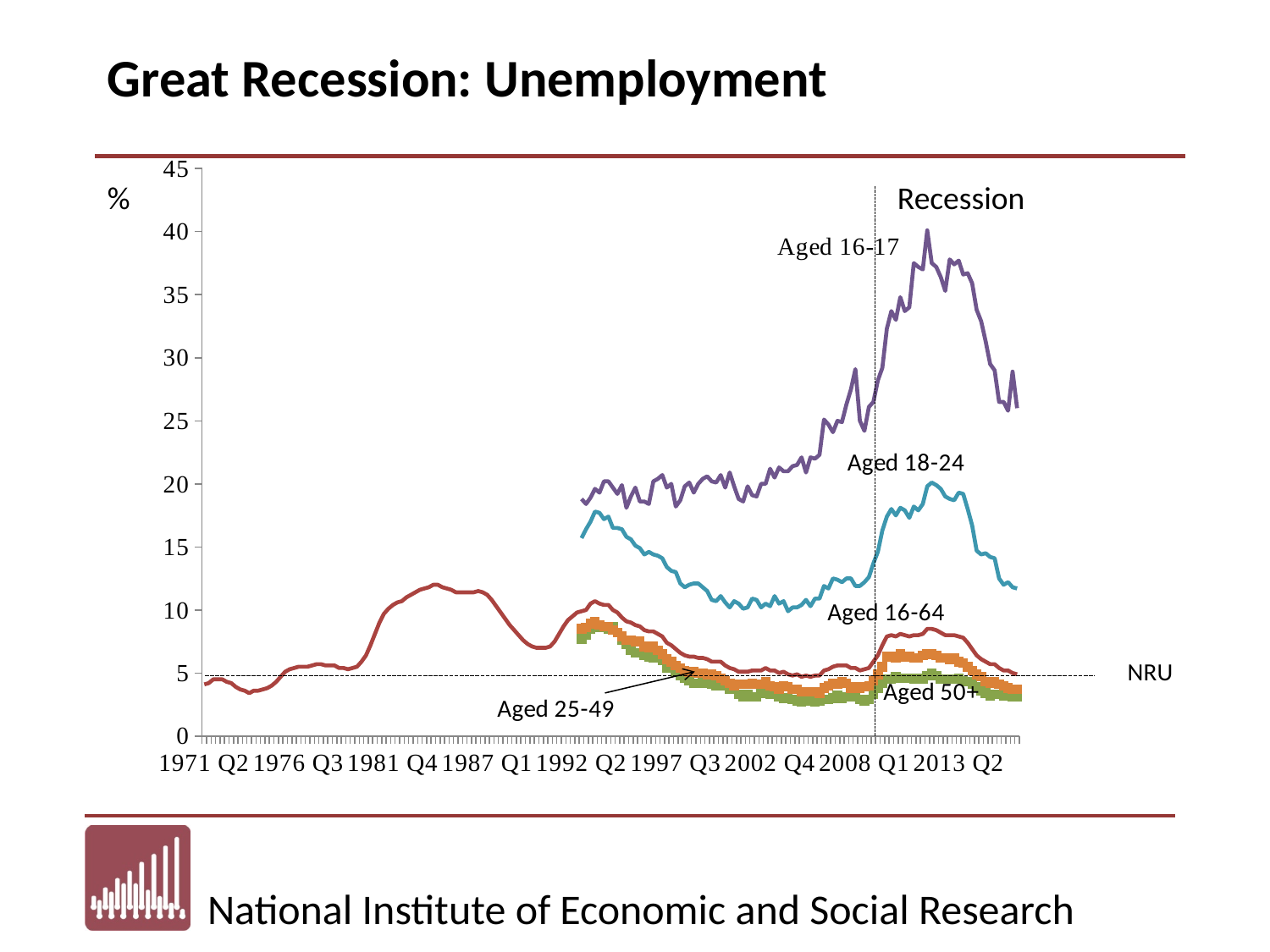
Is the peak value for Aged 18-24 greater or less than 15? greater Which age group has the highest unemployment rate throughout the period shown? Aged 16-17 What is the unit shown on the vertical axis? % Is the value for Aged 50+ at the end of the series greater or less than 5? less Is the peak value for Aged 18-24 greater or less than 25? less What is the title of the slide's chart? Great Recession: Unemployment What is the highest value shown on the vertical axis? 45 Does the Aged 16-17 series generally rise or fall between 1992 Q2 and 2013 Q2? rise Which series is higher around 2013 Q2, Aged 16-17 or Aged 18-24? Aged 16-17 What type of chart is shown on the slide? line chart How many age-group series are plotted on the chart? 5